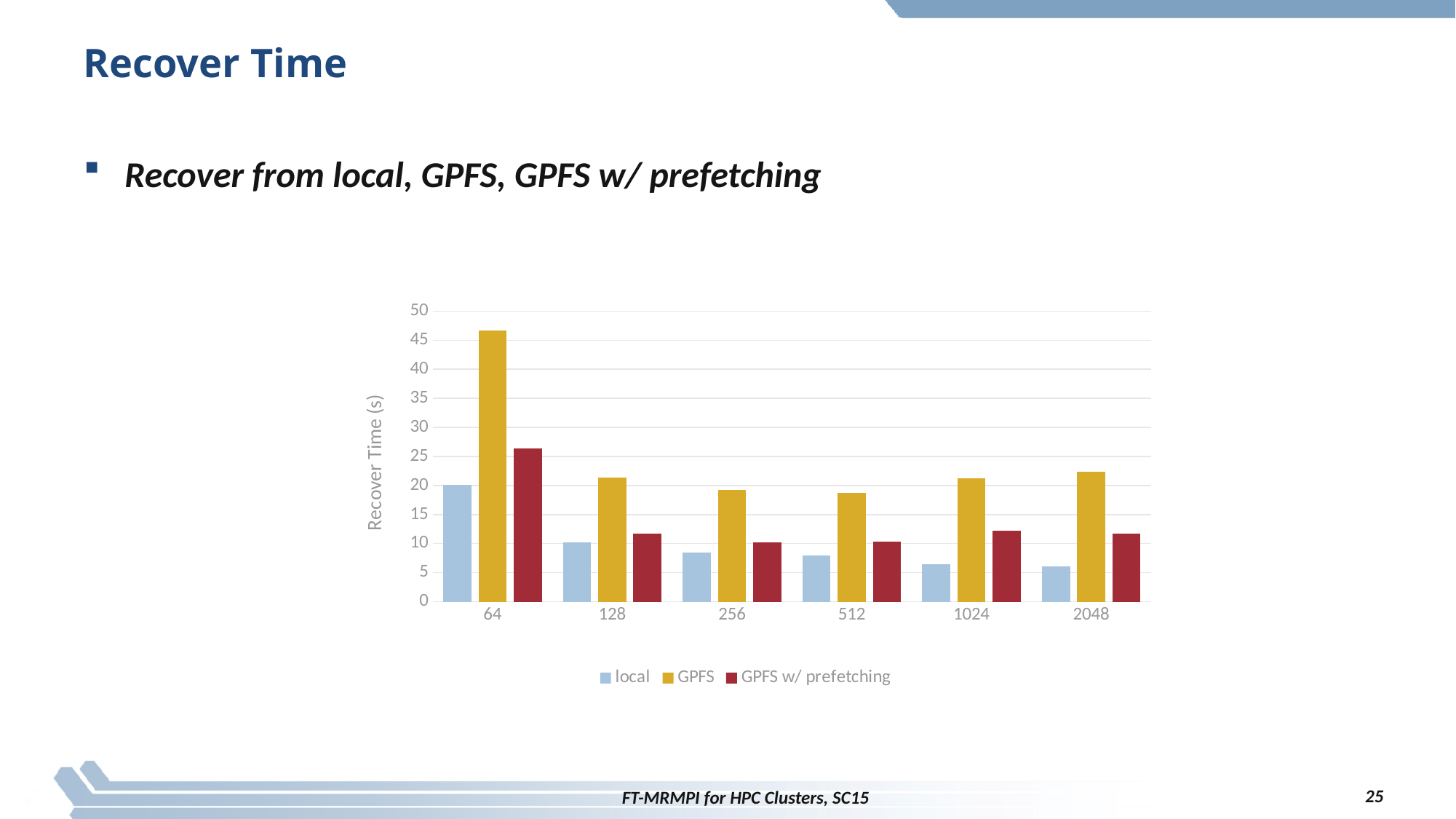
For the GPFS series, which category has the highest recover time? 64 Which colour represents the GPFS series in the legend? yellow Is the local value at 2048 greater or less than 10? less What is the title of the y axis? Recover Time (s) Is the GPFS w/ prefetching value at 64 greater or less than 20? greater How many series does the legend list? 3 At category 64, which is larger: GPFS or GPFS w/ prefetching? GPFS Is the GPFS value at 64 greater or less than 40? greater Do the values of the local series rise or fall as you move from 64 to 2048 along the x axis? fall How many categories are shown on the x axis? 6 At category 128, which series has the lowest recover time? local What kind of chart is shown on the slide? bar chart